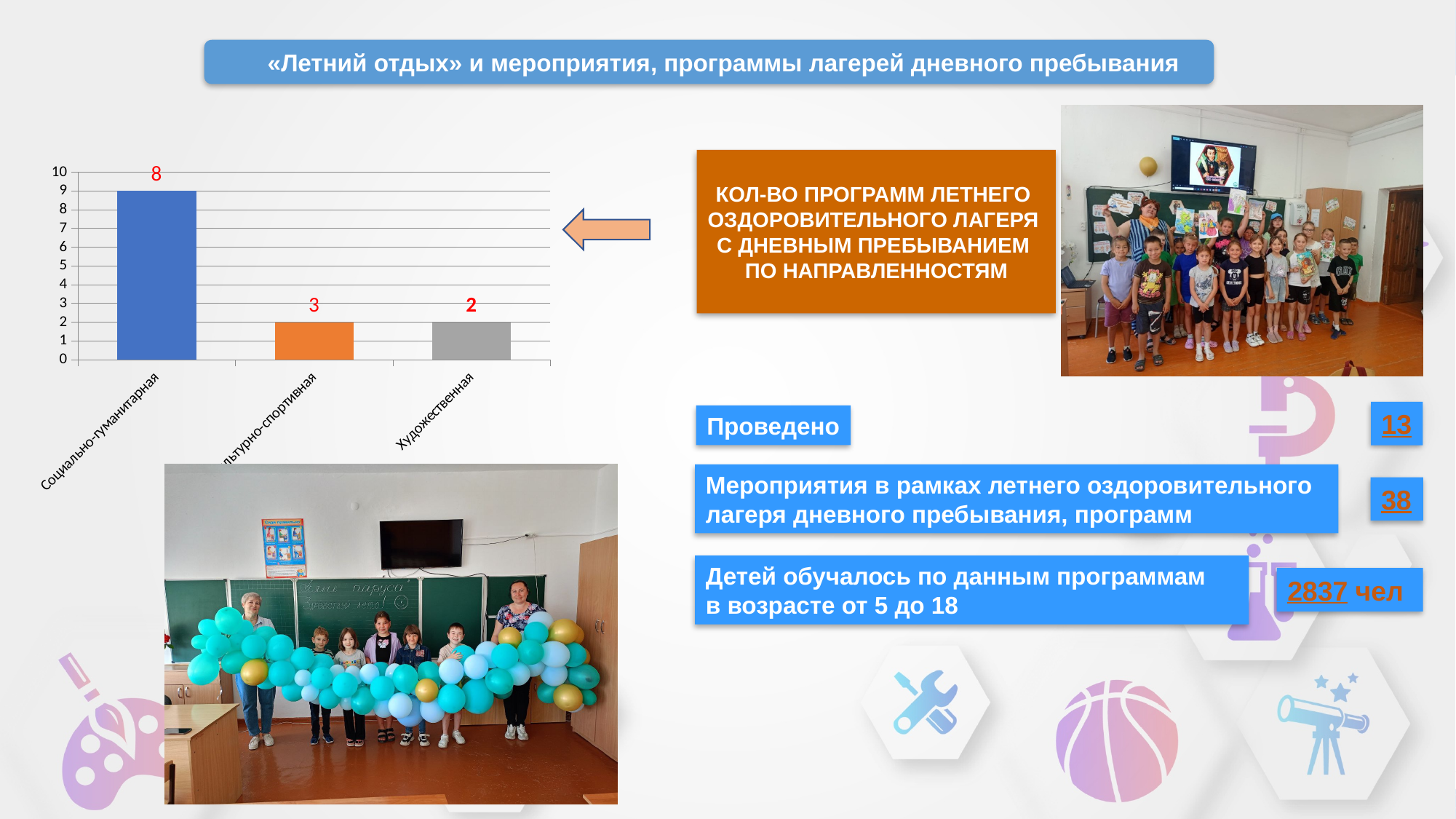
What is the difference between the values for Социально-гуманитарная and Художественная? 6 What kind of chart is shown on the slide? bar chart What colour is the bar for the Социально-гуманитарная category? blue What is the value shown for the Социально-гуманитарная category? 8 Is the value for Художественная greater or less than 5? less Which has a larger value, Социально-гуманитарная or Художественная? Социально-гуманитарная Which category has the highest value in the chart? Социально-гуманитарная What is the maximum value shown on the chart's vertical axis? 10 How many categories are shown in the chart? 3 What is the value shown for the Художественная category? 2 Is the value for Социально-гуманитарная greater or less than 5? greater